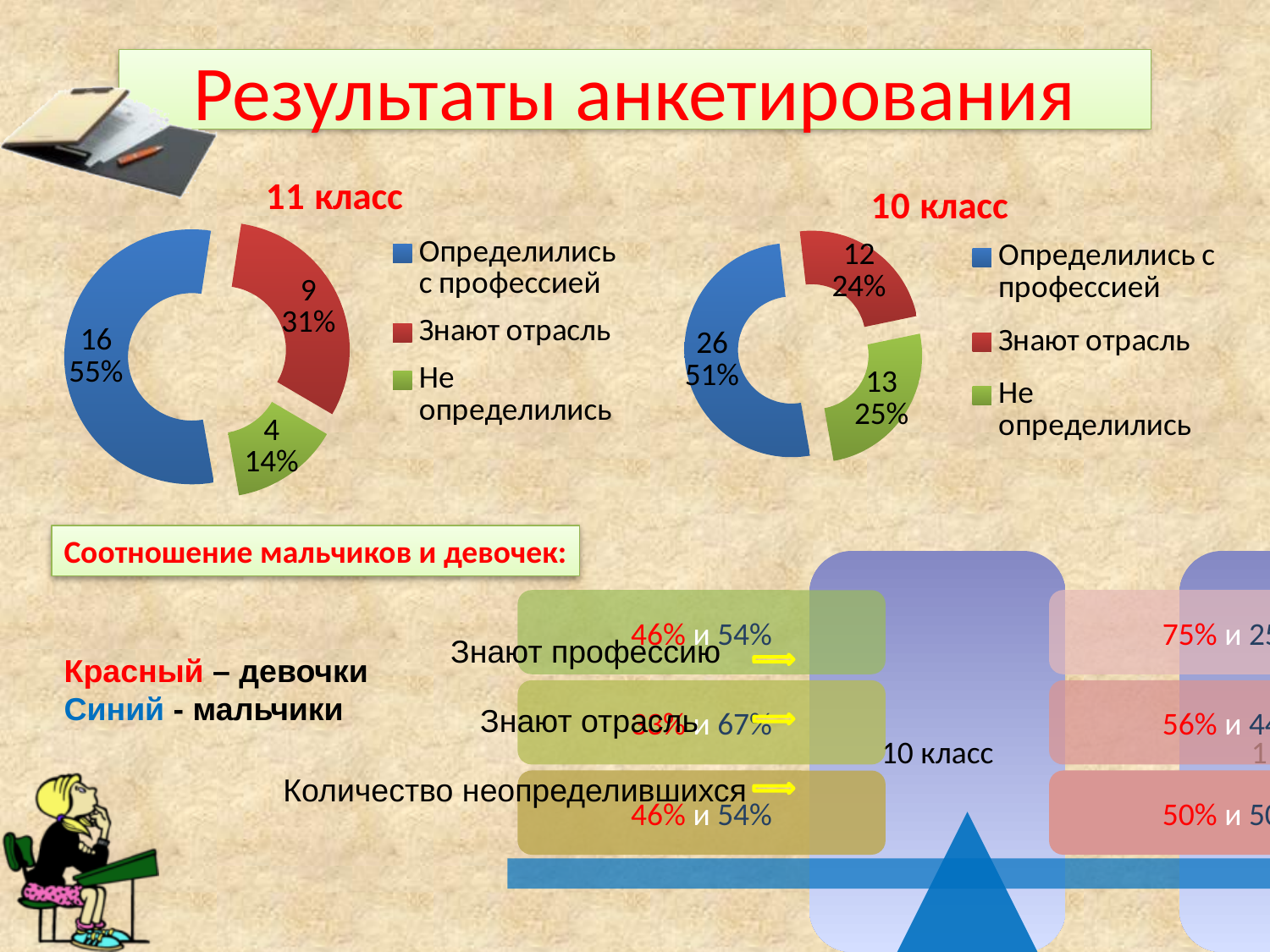
In the "11 класс" chart, what percentage share does "Знают отрасль" have? 31% In the "10 класс" chart, which category has the largest value? Определились с профессией In the "10 класс" chart, which is larger: "Знают отрасль" or "Не определились"? Не определились In the "10 класс" chart, what percentage share does "Определились с профессией" have? 51% What type of chart is used for "10 класс"? Pie (doughnut) chart How many categories does the "11 класс" chart show? 3 In the "11 класс" chart, which category has the smallest value? Не определились In the "10 класс" chart, how many students are in the "Не определились" category? 13 In the "11 класс" chart, what colour represents "Не определились"? Green In the "11 класс" chart, what is the difference between the "Определились с профессией" and "Знают отрасль" counts? 7 In the "11 класс" chart, how many students are in the "Определились с профессией" category? 16 In the "10 класс" chart, what is the total number of students across all three categories? 51